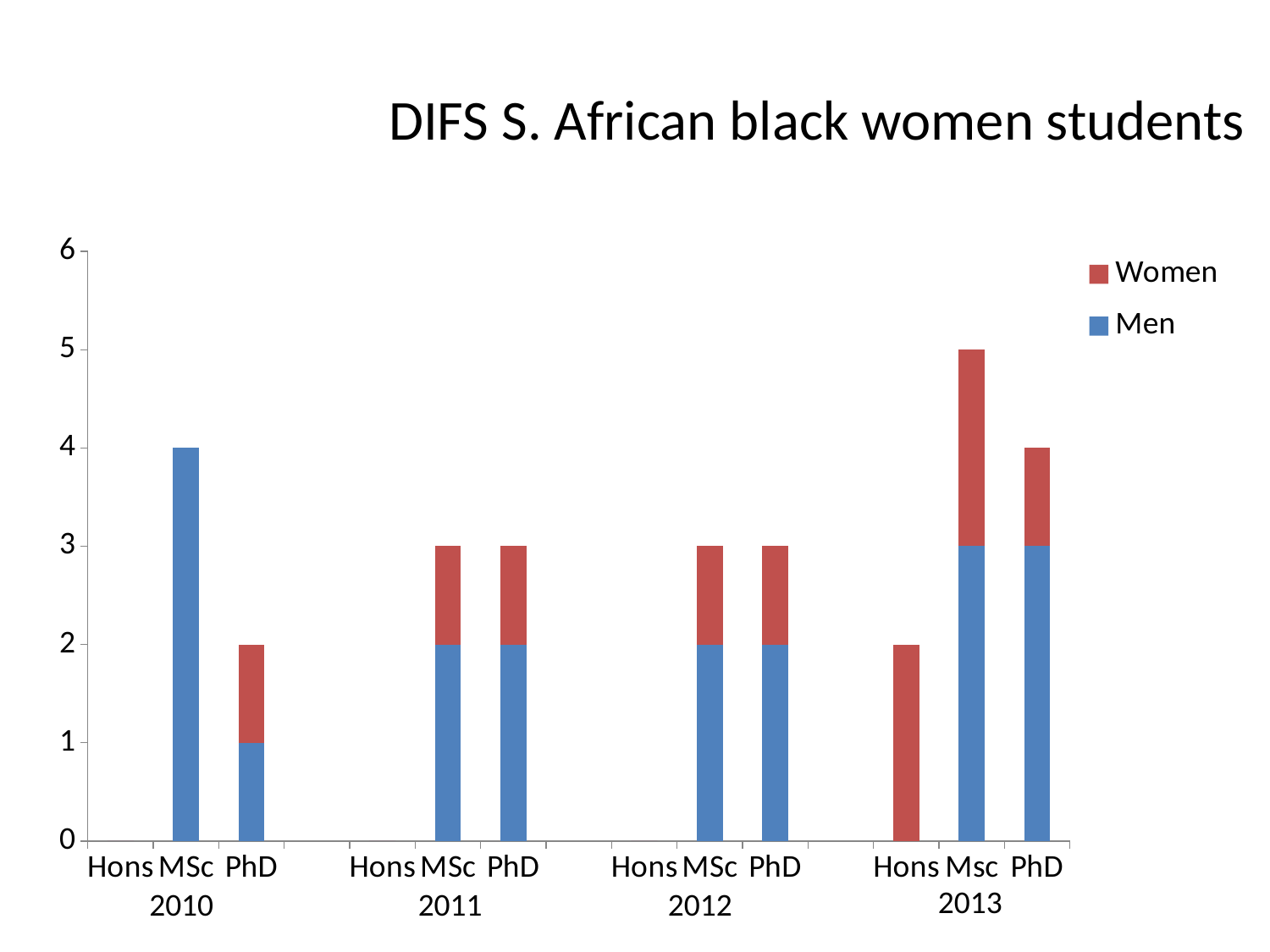
What is the difference between the total of the MSc bar for 2013 and the total of the PhD bar for 2010? 3 How many series does the legend list? 2 What is the total height of the MSc bar for 2013? 5 What kind of chart is shown on the slide? Stacked bar chart What is the value for Women in the Hons bar for 2013? 2 What is the total height of the PhD bar for 2013? 4 What is the value for Men in the MSc bar for 2010? 4 Is the total of the MSc bar for 2013 greater or less than 4? greater Which is larger, the total of the MSc bar for 2010 or the total of the MSc bar for 2011? MSc 2010 Which bar has the highest total across all years and degree levels? MSc 2013 What are the two series named in the legend? Women and Men What is the title of the chart? DIFS S. African black women students